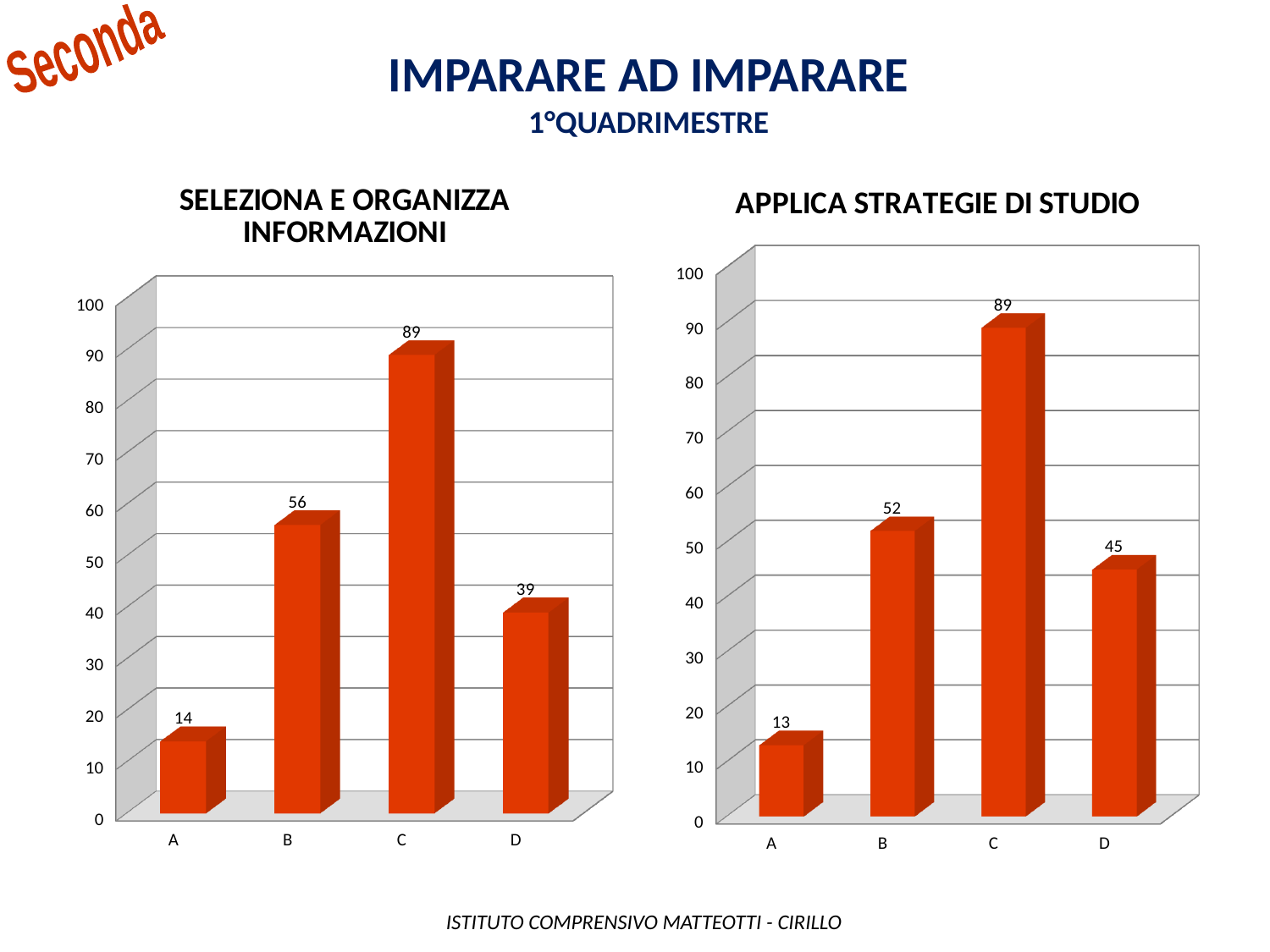
How many categories are shown in the 'APPLICA STRATEGIE DI STUDIO' chart? 4 In the 'SELEZIONA E ORGANIZZA INFORMAZIONI' chart, which category has the lowest value? A What kind of chart is the 'SELEZIONA E ORGANIZZA INFORMAZIONI' chart? Bar chart In the 'APPLICA STRATEGIE DI STUDIO' chart, which is larger, the value for B or the value for D? B What is the title of the chart on the right side of the slide? APPLICA STRATEGIE DI STUDIO In the 'SELEZIONA E ORGANIZZA INFORMAZIONI' chart, is the value for D greater or less than 40? less In the 'APPLICA STRATEGIE DI STUDIO' chart, what is the value for category D? 45 In the 'SELEZIONA E ORGANIZZA INFORMAZIONI' chart, what is the value for category C? 89 In the 'APPLICA STRATEGIE DI STUDIO' chart, what is the difference between the values for C and A? 76 In the 'APPLICA STRATEGIE DI STUDIO' chart, which category has the highest value? C In the 'SELEZIONA E ORGANIZZA INFORMAZIONI' chart, what is the difference between the values for B and D? 17 In the 'SELEZIONA E ORGANIZZA INFORMAZIONI' chart, what is the value for category A? 14